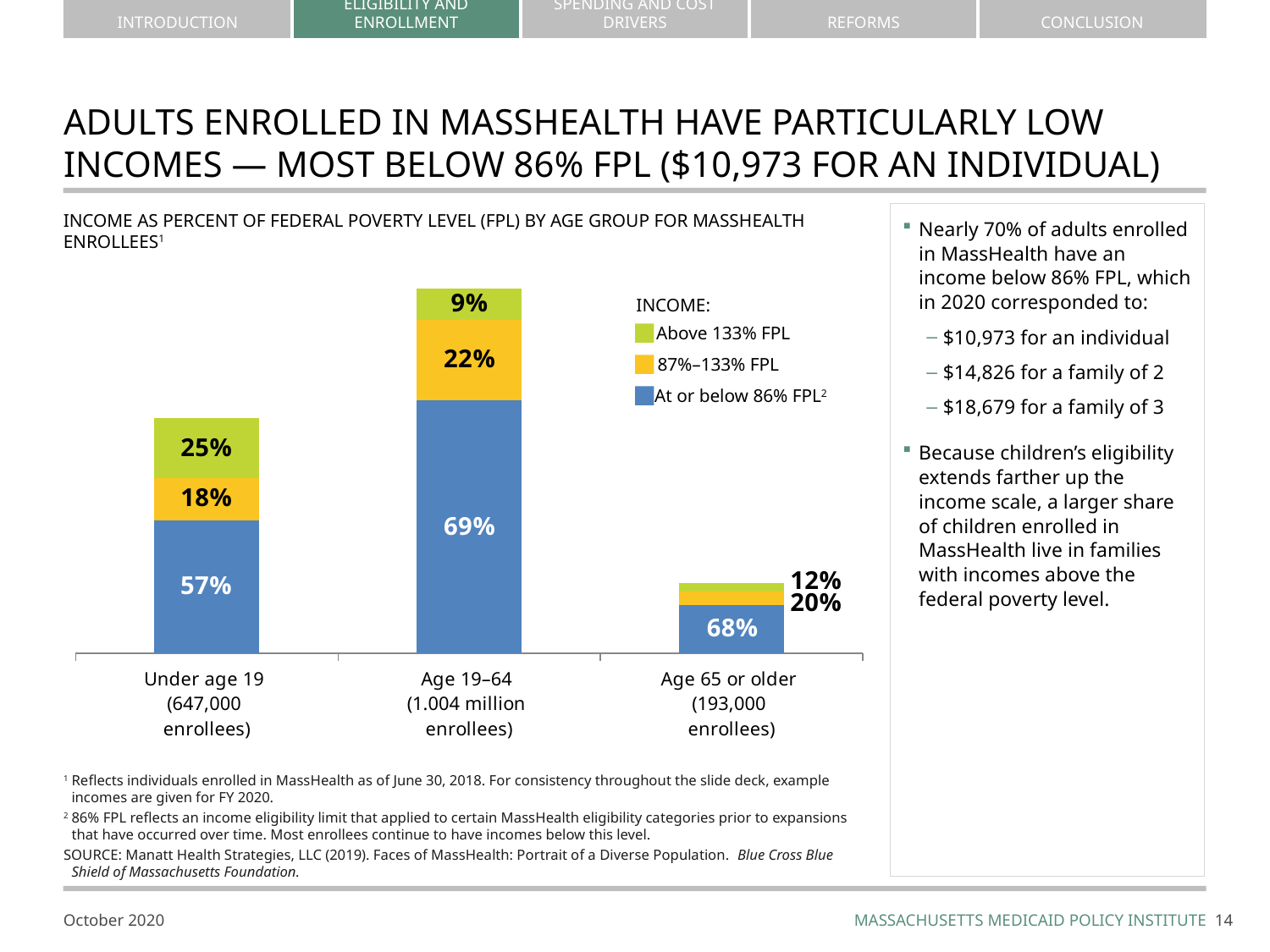
What percentage of enrollees aged 19–64 have incomes above 133% FPL? 9% Which age group has the lowest share of enrollees above 133% FPL? Age 19–64 What is the total of the three segments for the under age 19 bar? 100% What type of chart is shown on the slide? Stacked bar chart What percentage of enrollees aged 65 or older have incomes between 87% and 133% FPL? 20% What is the difference between the share of enrollees above 133% FPL for the under age 19 group and the age 19–64 group? 16% Which is larger: the share of enrollees at or below 86% FPL for age 19–64 or for age 65 or older? Age 19–64 How many enrollees are in the age 19–64 group according to the axis label? 1.004 million enrollees How many income categories does the legend list? 3 Which age group has the highest share of enrollees at or below 86% FPL? Age 19–64 What percentage of MassHealth enrollees under age 19 have incomes at or below 86% FPL? 57% How many age groups are shown on the chart? 3